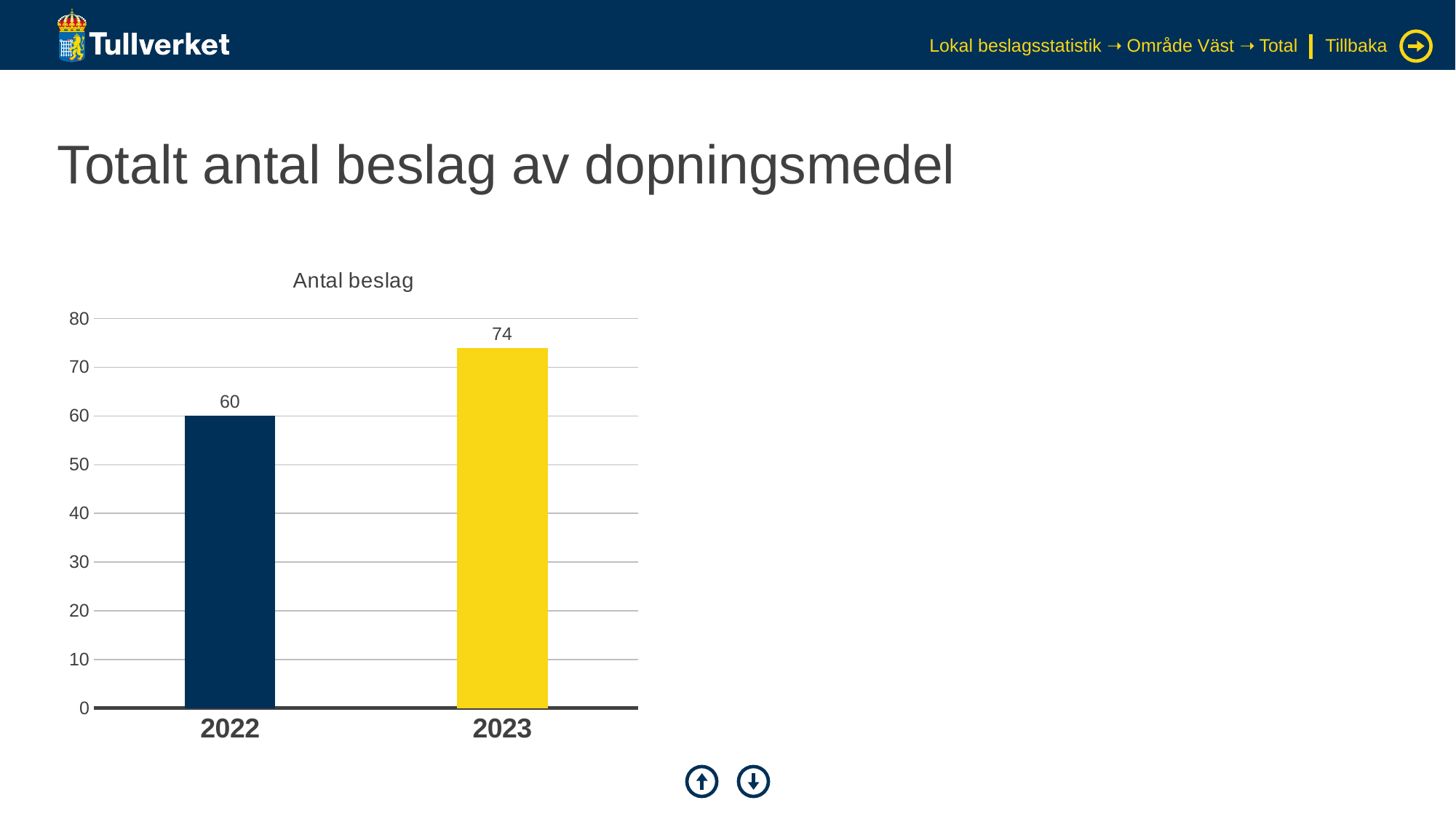
Which year has the lowest number of seizures? 2022 Do the values rise or fall from 2022 to 2023? rise Is the value for 2022 greater or less than 70? less What is the title of the chart? Antal beslag What is the value for 2023? 74 What kind of chart is shown on the slide? bar chart How many years are shown on the x axis? 2 Is the value for 2023 greater or less than 70? greater What is the value for 2022? 60 Which is larger, the value for 2022 or the value for 2023? 2023 What is the difference between the values for 2023 and 2022? 14 Which year has the highest number of seizures? 2023